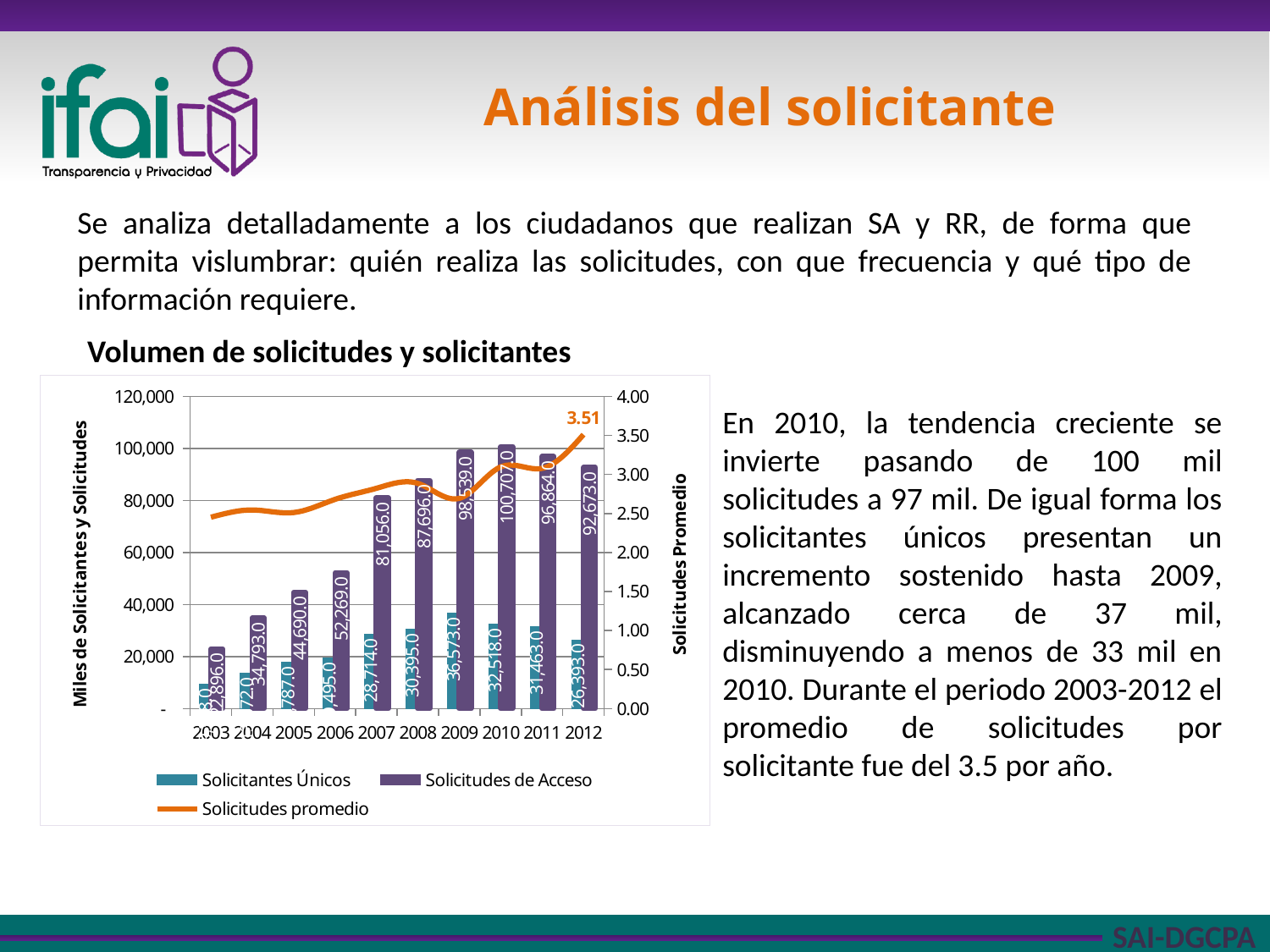
What is the difference between Solicitudes de Acceso in 2010 and 2011? 3,843.0 Do the Solicitudes de Acceso values rise or fall from 2003 to 2010? rise How many series does the chart legend list? 3 How many years are shown on the x axis of the chart? 10 What is the value of Solicitantes Únicos for 2009? 36,573.0 In which year is Solicitantes Únicos highest? 2009 What value is labelled on the Solicitudes promedio line for 2012? 3.51 What is the value of Solicitudes de Acceso for 2010? 100,707.0 What is the value of Solicitudes de Acceso for 2005? 44,690.0 Which year has the larger value of Solicitudes de Acceso, 2008 or 2012? 2012 Is the value of Solicitudes de Acceso for 2006 greater or less than 60,000? less In which year is Solicitudes de Acceso highest? 2010